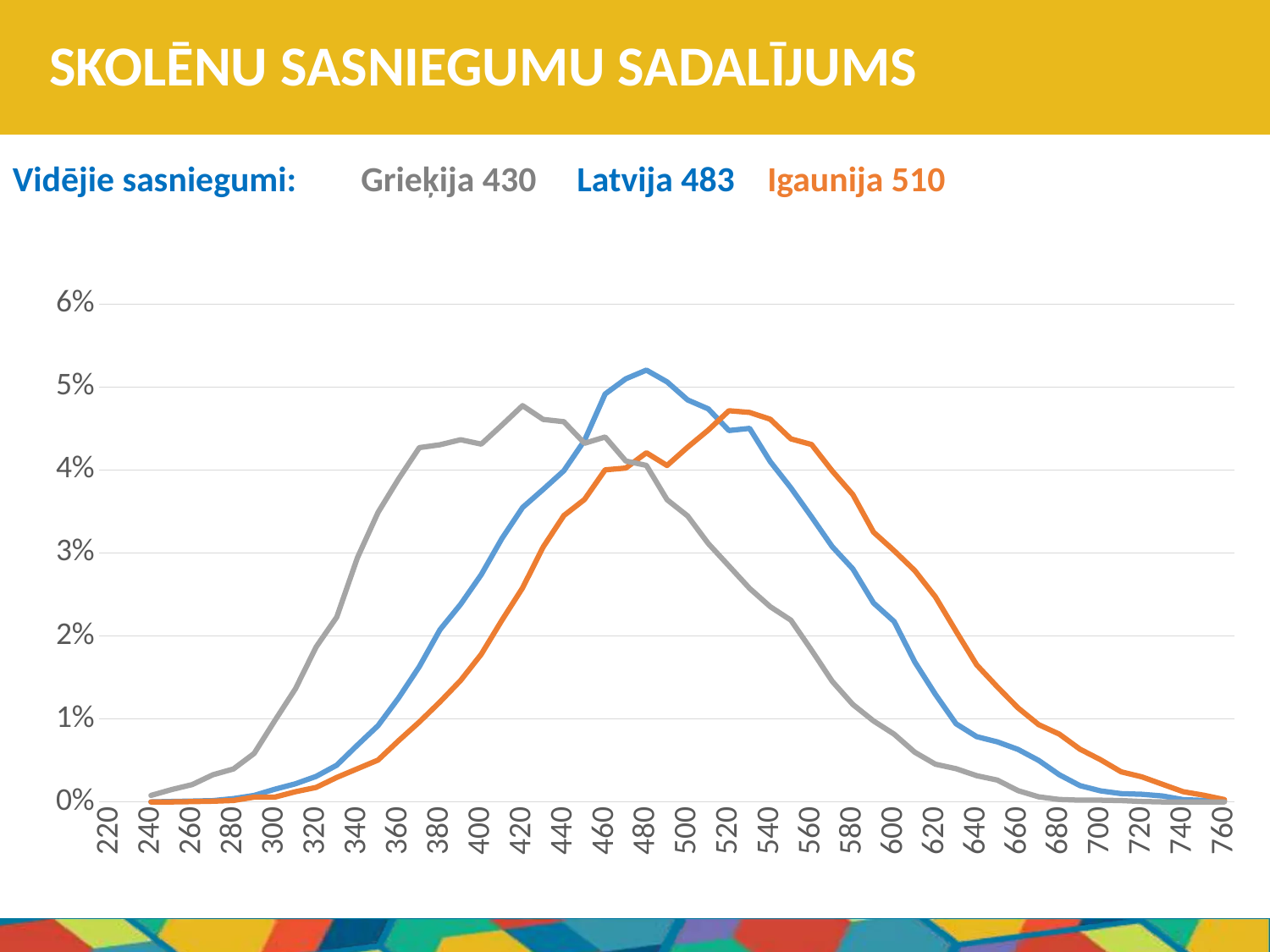
How many series (countries) are plotted on the chart? 3 Is the value for Grieķija at 420 greater or less than 5%? less Which series reaches the highest peak on the chart? Latvija Which series has its peak at the lowest score on the x axis? Grieķija Does the Latvija line rise or fall between 240 and 480? rise What kind of chart is shown on the slide? line chart Is the value for Latvija at 480 greater or less than 5%? greater Is the value for Igaunija at 580 greater or less than 3%? greater What is the title of the slide? SKOLĒNU SASNIEGUMU SADALĪJUMS At 360, which series has the higher value, Grieķija or Latvija? Grieķija At 600, which series has the higher value, Igaunija or Latvija? Igaunija